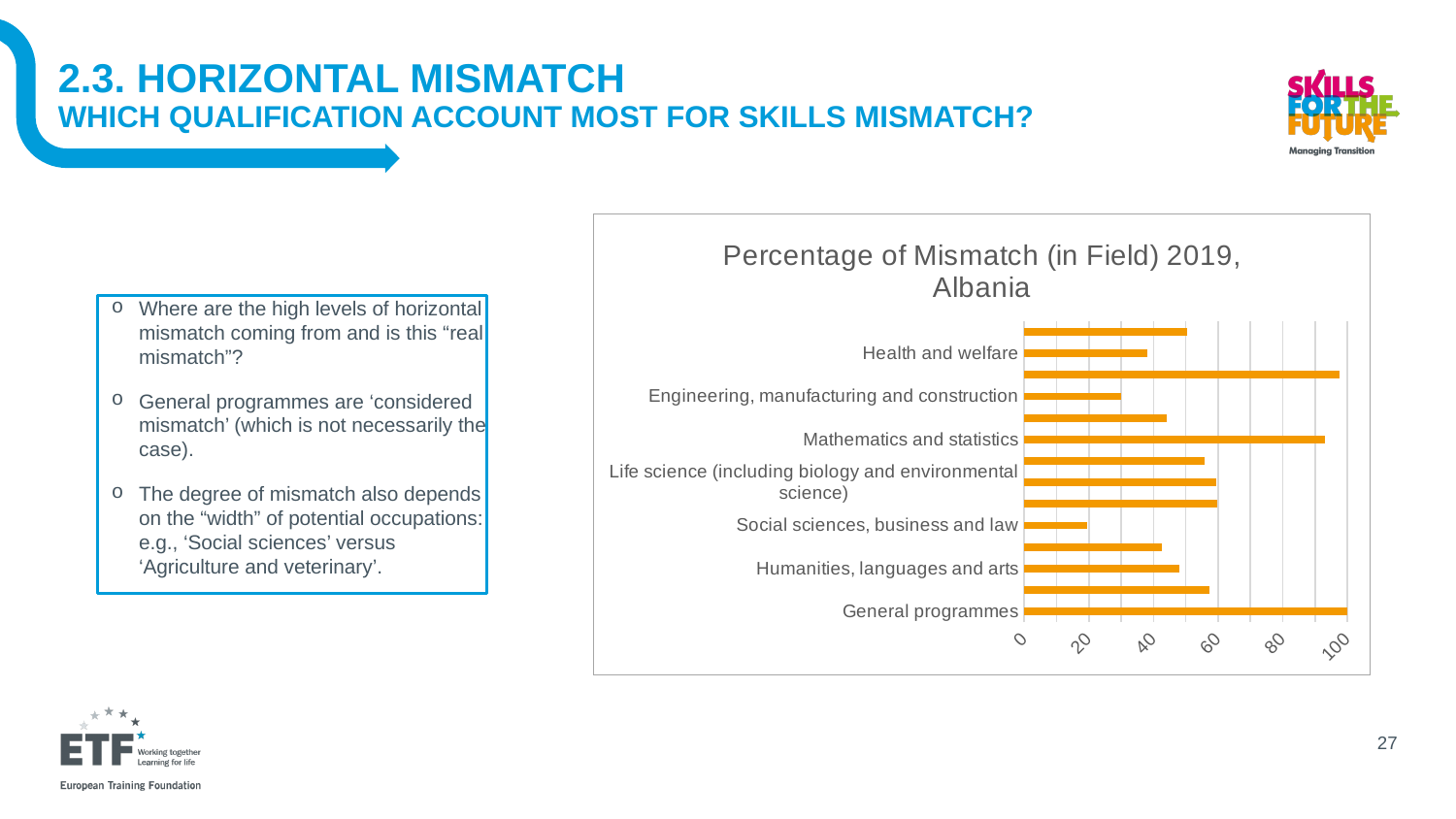
Is the value for Engineering, manufacturing and construction greater or less than 40? less How many category labels are shown on the vertical axis of the chart? 7 Which is larger, the value for Mathematics and statistics or the value for Health and welfare? Mathematics and statistics Is the value for General programmes greater or less than 80? greater What is the title of the chart? Percentage of Mismatch (in Field) 2019, Albania What kind of chart is shown on the slide? Bar chart Is the value for Health and welfare greater or less than 60? less What colour are the bars in the chart? Orange Which is larger, the value for Life science (including biology and environmental science) or the value for Social sciences, business and law? Life science (including biology and environmental science) Which of the labelled categories has the shortest bar? Social sciences, business and law